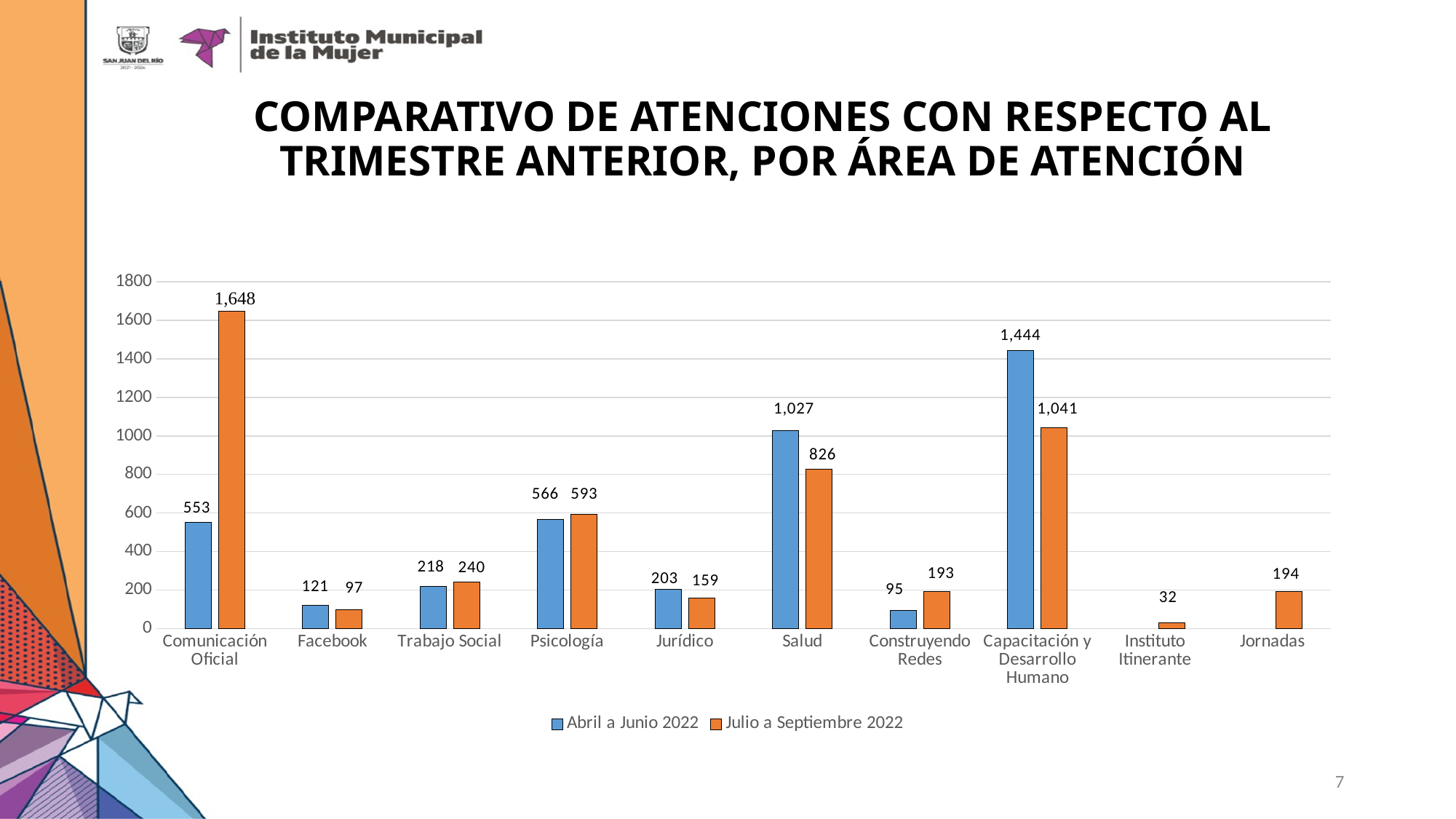
What is the value for Salud in the Abril a Junio 2022 series? 1,027 Which category has the highest value in the Julio a Septiembre 2022 series? Comunicación Oficial What is the value for Comunicación Oficial in the Julio a Septiembre 2022 series? 1,648 How many categories are shown on the x axis? 10 Which colour represents the Julio a Septiembre 2022 series? Orange How many series does the legend list? 2 What is the difference between the Abril a Junio 2022 and Julio a Septiembre 2022 values for Capacitación y Desarrollo Humano? 403 Which is larger for Jurídico: the Abril a Junio 2022 value or the Julio a Septiembre 2022 value? Abril a Junio 2022 What kind of chart is shown on the slide? Bar chart Which category has the lowest value in the Abril a Junio 2022 series among those with a bar? Construyendo Redes What is the value for Instituto Itinerante in the Julio a Septiembre 2022 series? 32 Is the Julio a Septiembre 2022 value for Salud greater or less than 800? greater